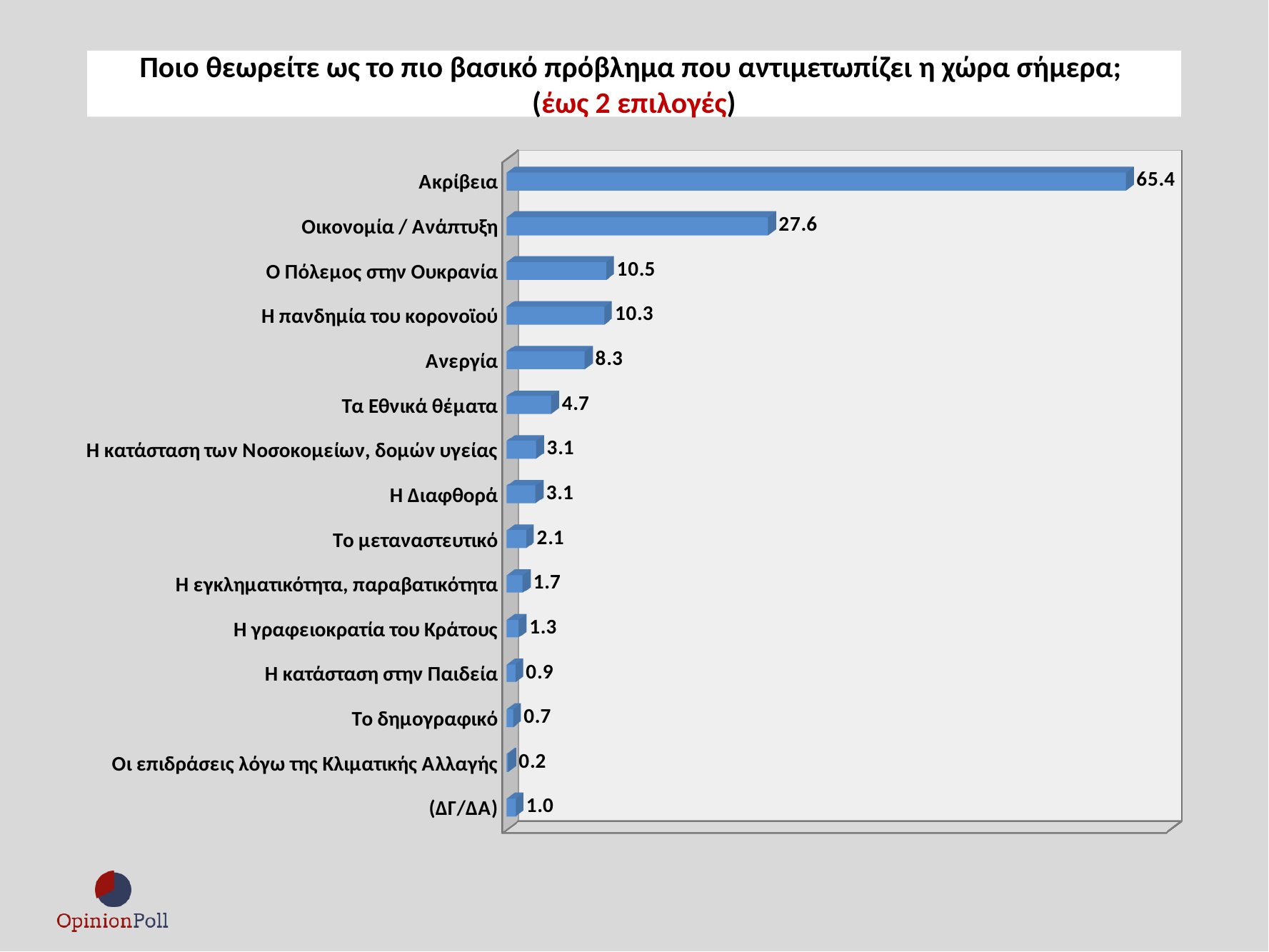
Which is larger, the value for Ανεργία or the value for Τα Εθνικά θέματα? Ανεργία Which category has the lowest value? Οι επιδράσεις λόγω της Κλιματικής Αλλαγής What is the value for Το μεταναστευτικό? 2.1 What is the difference between the values for Ακρίβεια and Οικονομία / Ανάπτυξη? 37.8 What is the value for Ακρίβεια? 65.4 What is the value for Οικονομία / Ανάπτυξη? 27.6 What kind of chart is shown on the slide? Bar chart How many categories are shown in the chart? 15 What is the difference between the values for Ο Πόλεμος στην Ουκρανία and Η πανδημία του κορονοϊού? 0.2 What is the value for (ΔΓ/ΔΑ)? 1.0 What is the value for Η πανδημία του κορονοϊού? 10.3 Which category has the highest value? Ακρίβεια